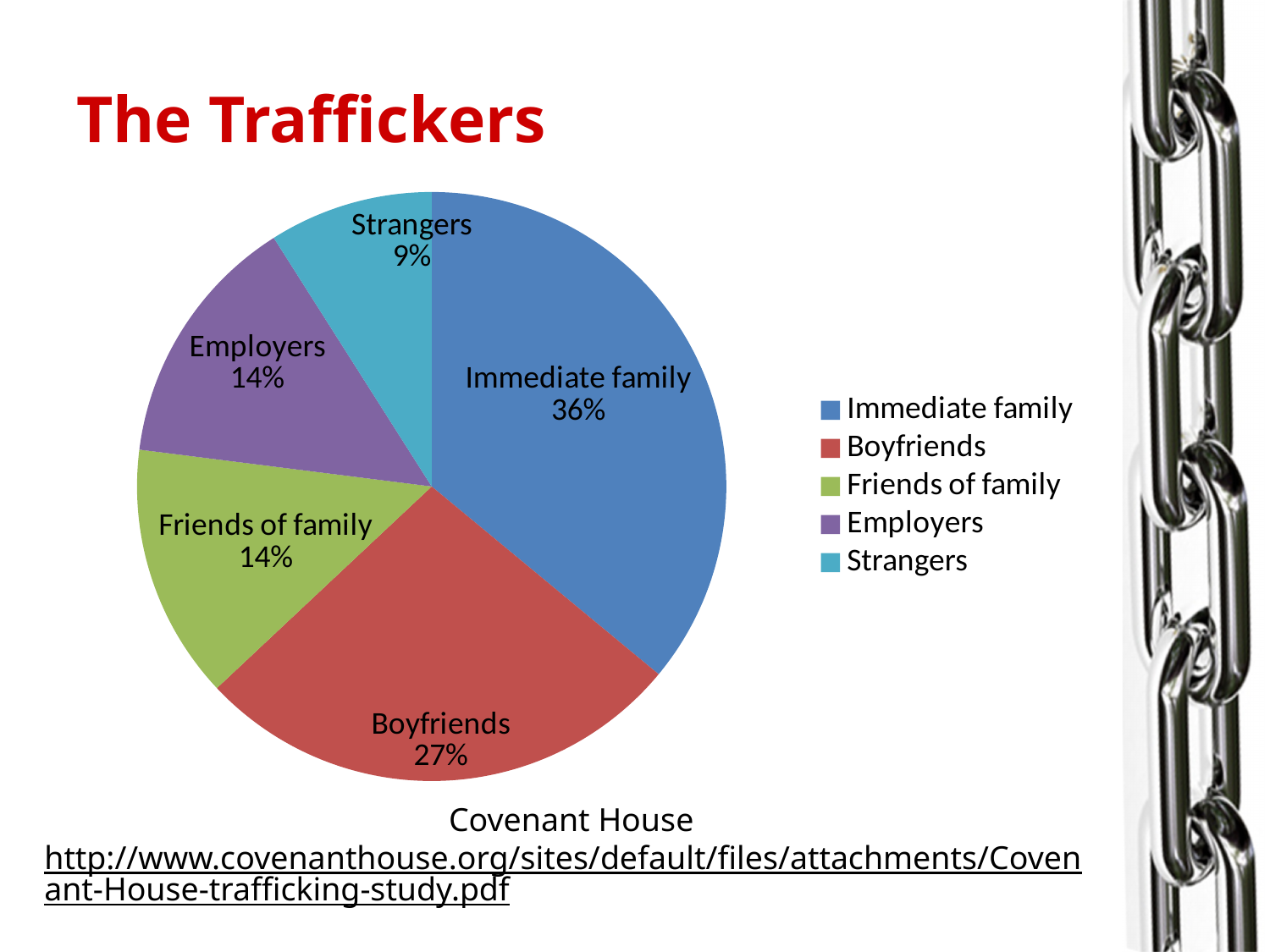
What is the value shown for Employers? 14% Which is larger, the share for Boyfriends or the share for Employers? Boyfriends What is the difference in percentage points between Immediate family and Boyfriends? 9 Which category has the smallest slice of the pie? Strangers How many categories does the pie chart have? 5 Which category has the largest slice of the pie? Immediate family What is the value shown for Strangers? 9% How many entries does the legend list? 5 What colour is the Friends of family slice? Green What kind of chart is shown on the slide? Pie chart What is the value shown for Boyfriends? 27% What share of the pie is Immediate family? 36%